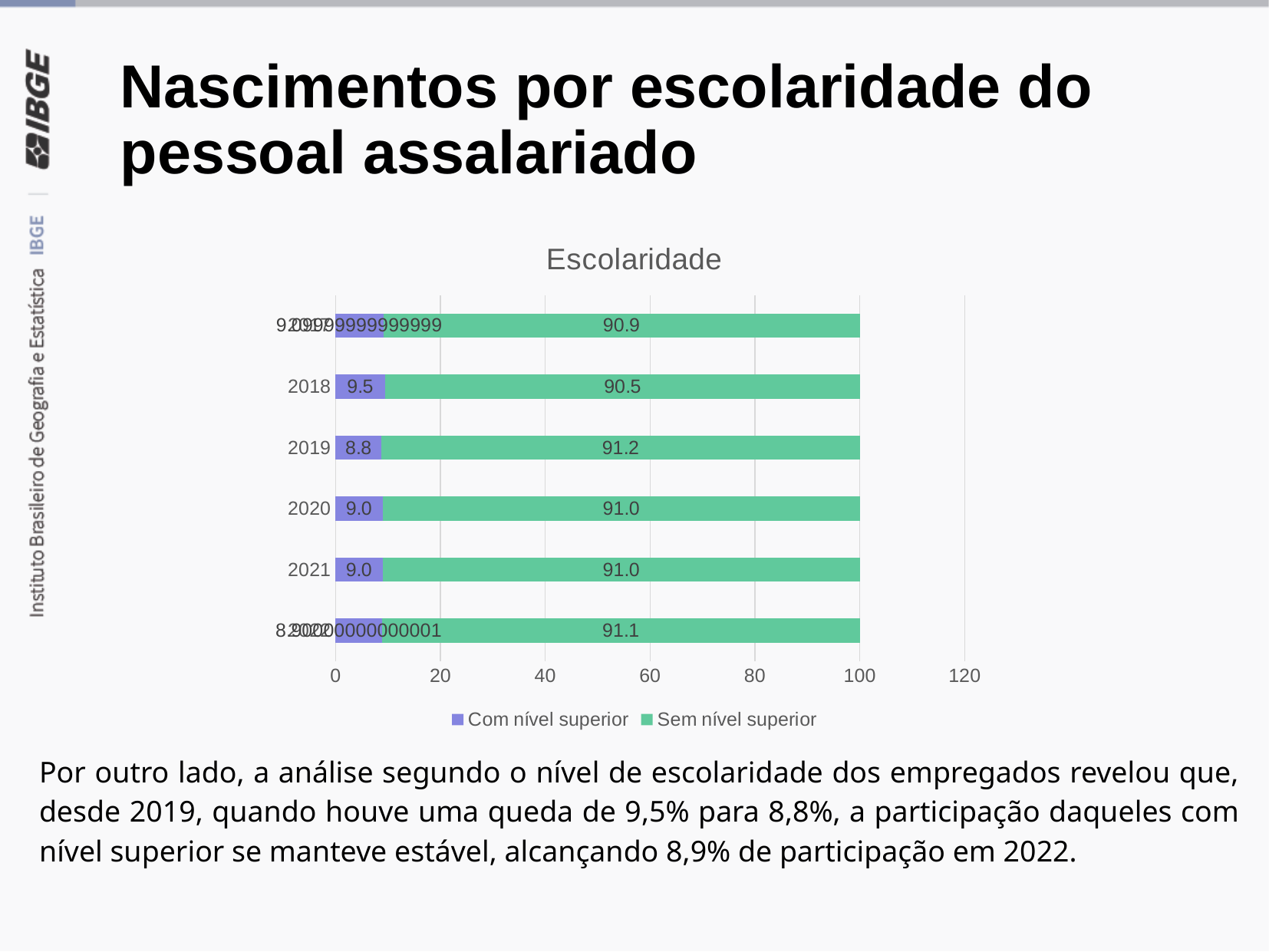
Which year has the highest value for Com nível superior? 2018 What is the title of the chart? Escolaridade What is the value for Com nível superior in 2018? 9.5 What is the value for Sem nível superior in 2019? 91.2 What is the difference between the Com nível superior values for 2018 and 2019? 0.7 Is the value for Sem nível superior in 2021 greater or less than 80? greater Which year has the lowest value for Sem nível superior? 2018 What kind of chart is shown on the slide? bar chart What is the value for Com nível superior in 2019? 8.8 How many series does the legend of the Escolaridade chart list? 2 Which year has the larger Sem nível superior value, 2019 or 2020? 2019 What is the total of the stacked bar for 2020? 100